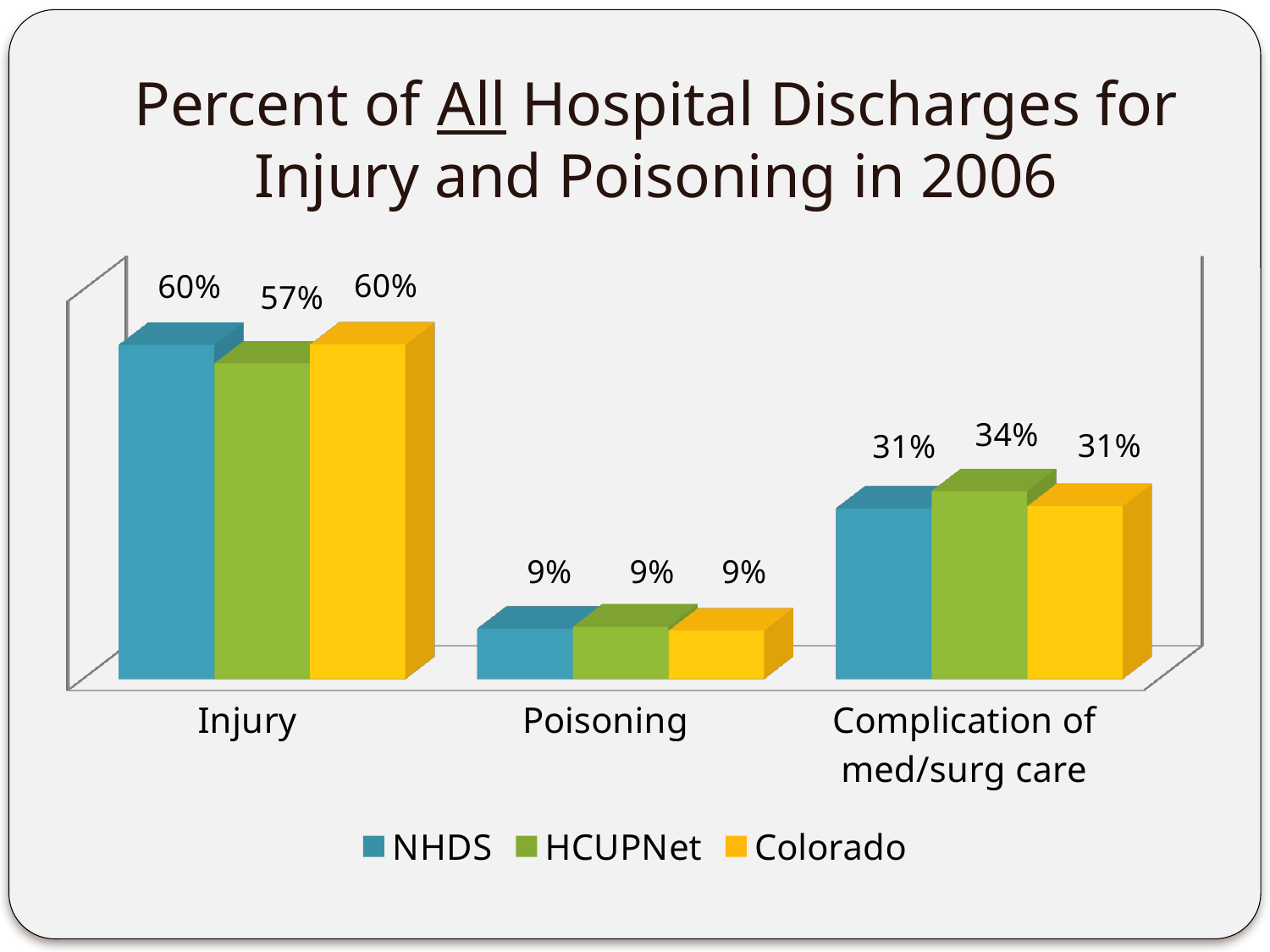
What is the Colorado value for Complication of med/surg care? 31% Which is larger for Complication of med/surg care, the HCUPNet value or the NHDS value? HCUPNet What kind of chart is shown on the slide? Bar chart How many series does the legend list? 3 What is the HCUPNet value for Poisoning? 9% Which category has the highest NHDS value? Injury How many categories are shown on the x axis? 3 What is the title of the chart? Percent of All Hospital Discharges for Injury and Poisoning in 2006 What is the HCUPNet value for Injury? 57% What is the NHDS value for Injury? 60% What is the difference between the NHDS and HCUPNet values for Injury? 3% Which category has the lowest Colorado value? Poisoning